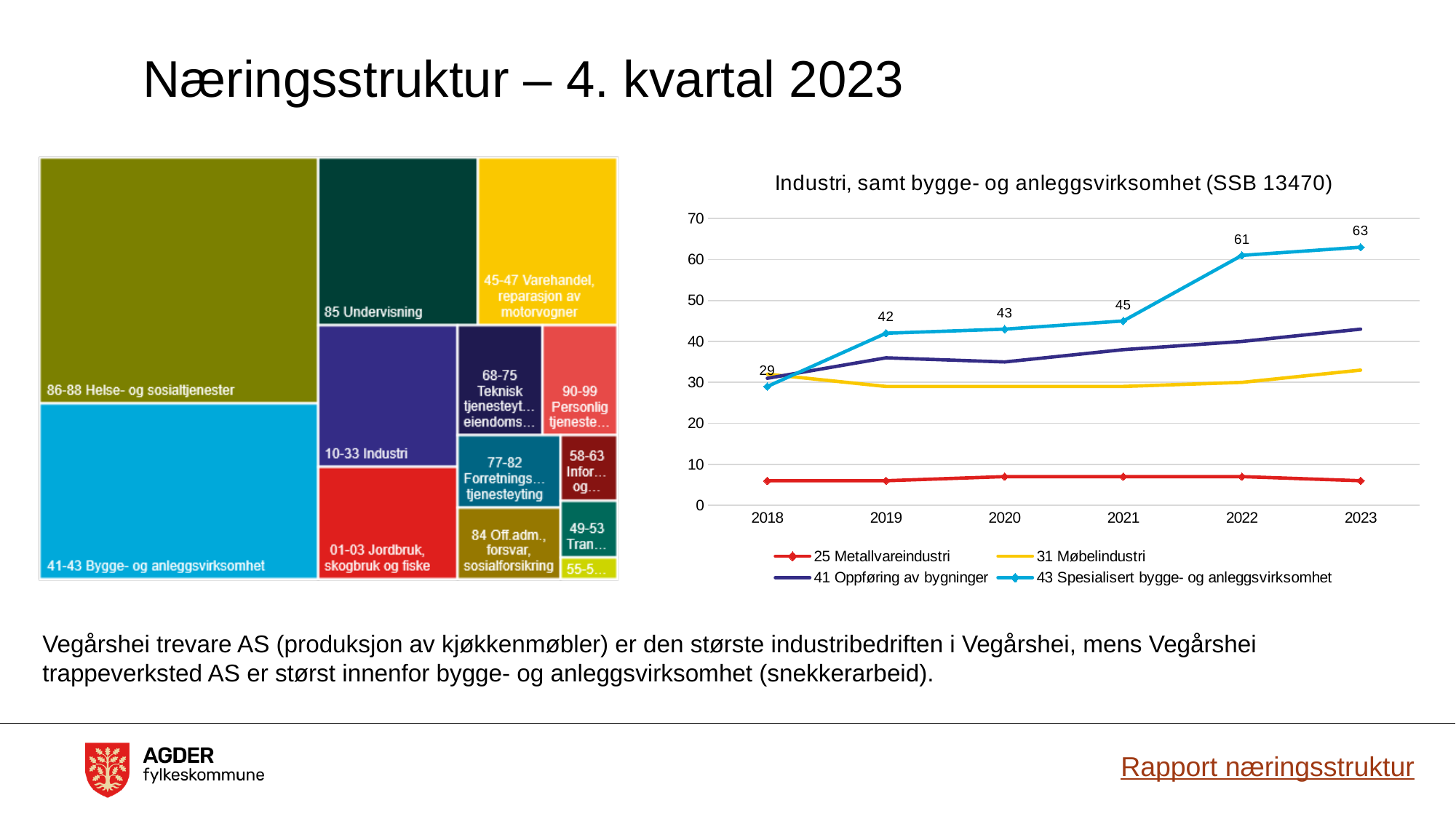
In the line chart 'Industri, samt bygge- og anleggsvirksomhet (SSB 13470)', in which year is 43 Spesialisert bygge- og anleggsvirksomhet highest? 2023 In the line chart 'Industri, samt bygge- og anleggsvirksomhet (SSB 13470)', what is the difference between the 2023 and 2018 values for 43 Spesialisert bygge- og anleggsvirksomhet? 34 In the line chart 'Industri, samt bygge- og anleggsvirksomhet (SSB 13470)', which year has the larger value for 43 Spesialisert bygge- og anleggsvirksomhet, 2021 or 2022? 2022 How many years are shown on the x axis of the line chart 'Industri, samt bygge- og anleggsvirksomhet (SSB 13470)'? 6 In the line chart 'Industri, samt bygge- og anleggsvirksomhet (SSB 13470)', in which year is 43 Spesialisert bygge- og anleggsvirksomhet lowest? 2018 In the line chart 'Industri, samt bygge- og anleggsvirksomhet (SSB 13470)', is the value for 25 Metallvareindustri in 2023 greater or less than 10? less What kind of chart is the chart titled 'Industri, samt bygge- og anleggsvirksomhet (SSB 13470)'? Line chart In the line chart 'Industri, samt bygge- og anleggsvirksomhet (SSB 13470)', what is the value for 43 Spesialisert bygge- og anleggsvirksomhet in 2023? 63 In the line chart 'Industri, samt bygge- og anleggsvirksomhet (SSB 13470)', is the value for 41 Oppføring av bygninger in 2023 greater or less than 40? greater In the line chart 'Industri, samt bygge- og anleggsvirksomhet (SSB 13470)', what is the value for 43 Spesialisert bygge- og anleggsvirksomhet in 2018? 29 How many series does the legend of the line chart 'Industri, samt bygge- og anleggsvirksomhet (SSB 13470)' list? 4 In the line chart 'Industri, samt bygge- og anleggsvirksomhet (SSB 13470)', does 43 Spesialisert bygge- og anleggsvirksomhet rise or fall from 2018 to 2023? Rise